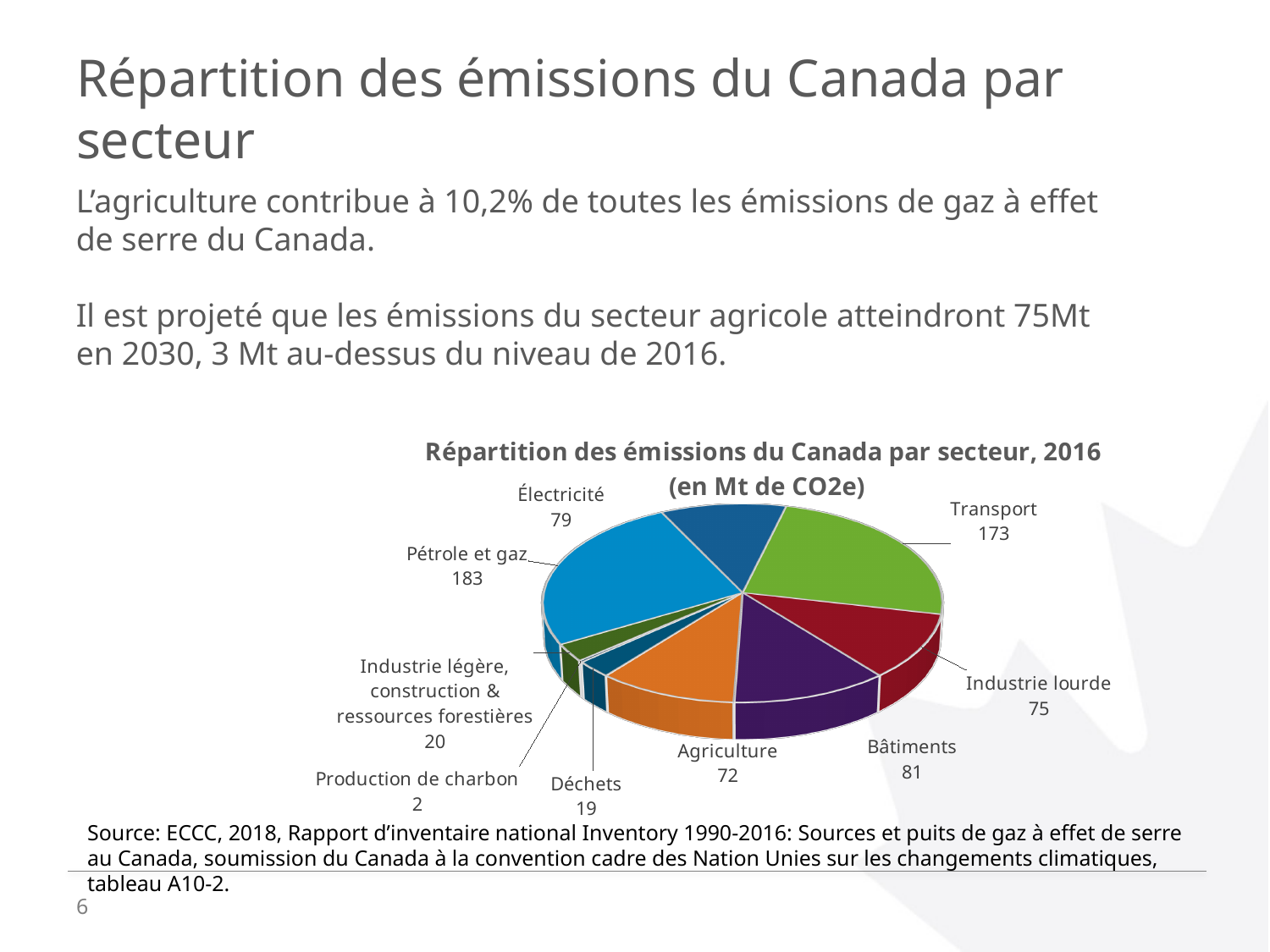
Which is larger, the value for Bâtiments or the value for Électricité? Bâtiments Which sector has the smallest emissions in the pie chart? Production de charbon What is the value for Industrie légère, construction & ressources forestières? 20 What is the total of all the sector values shown in the pie chart? 704 What is the difference between the values for Pétrole et gaz and Transport? 10 What kind of chart is shown on the slide? pie chart What is the value for Agriculture in the pie chart? 72 What is the title of the pie chart? Répartition des émissions du Canada par secteur, 2016 (en Mt de CO2e) What is the value for Transport in the pie chart? 173 How many sectors are shown in the pie chart? 9 Which sector has the largest emissions in the pie chart? Pétrole et gaz What is the value for Déchets in the pie chart? 19